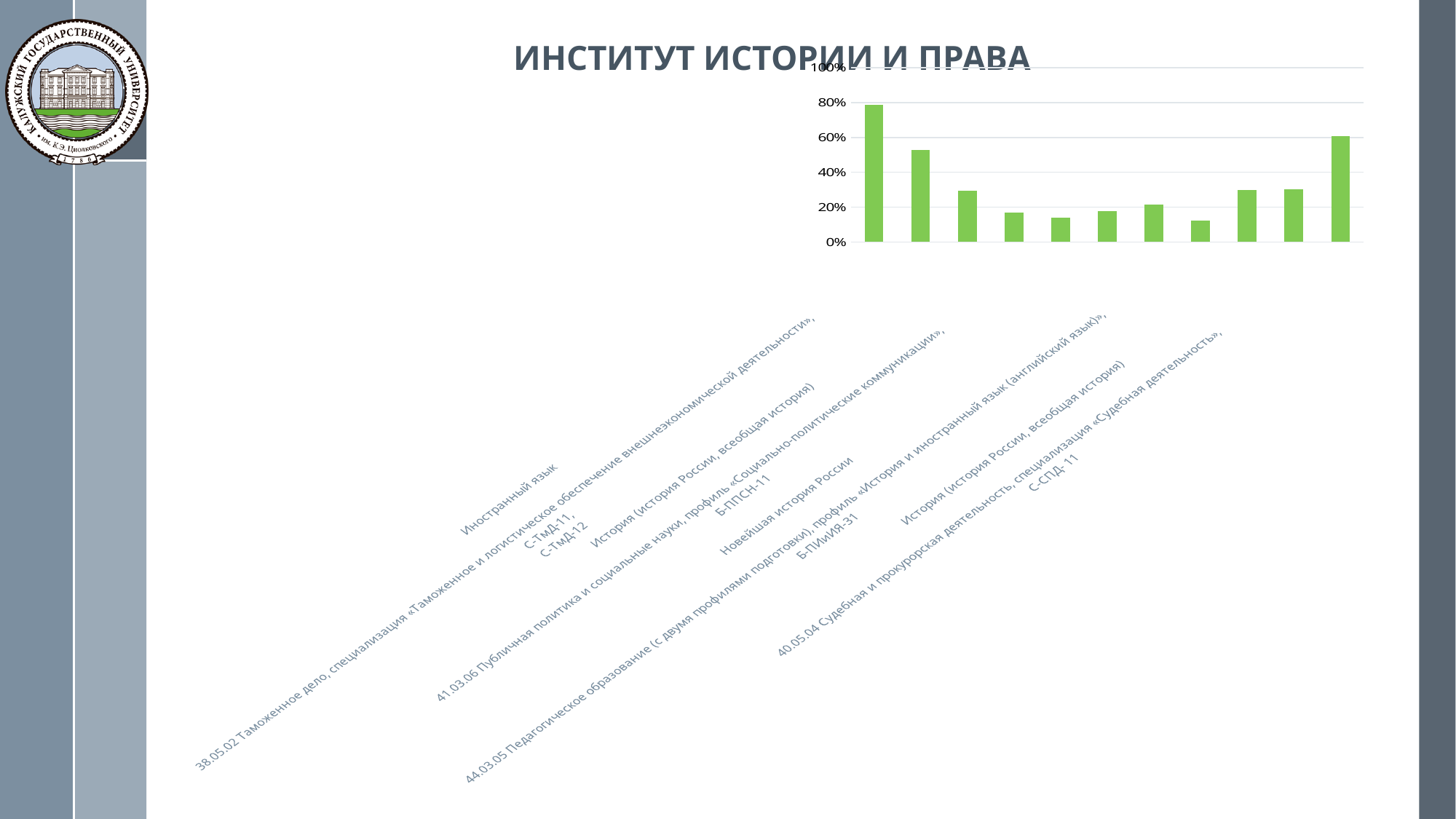
Which is larger, the first (leftmost) bar or the last (rightmost) bar? the first bar Is the value of the last (rightmost) bar greater or less than 40%? greater What is the title shown above the chart on the slide? ИНСТИТУТ ИСТОРИИ И ПРАВА How many bars are plotted in the chart? 11 Which is larger, the second bar from the left or the last (rightmost) bar? the last bar Is the value of the eighth bar from the left greater or less than 20%? less Which bar is the tallest in the chart, counting from the left? the first bar Which bar is the shortest in the chart, counting from the left? the eighth bar Is the value of the first (leftmost) bar greater or less than 60%? greater What kind of chart is shown on the slide? bar chart What colour are the bars in the chart? green